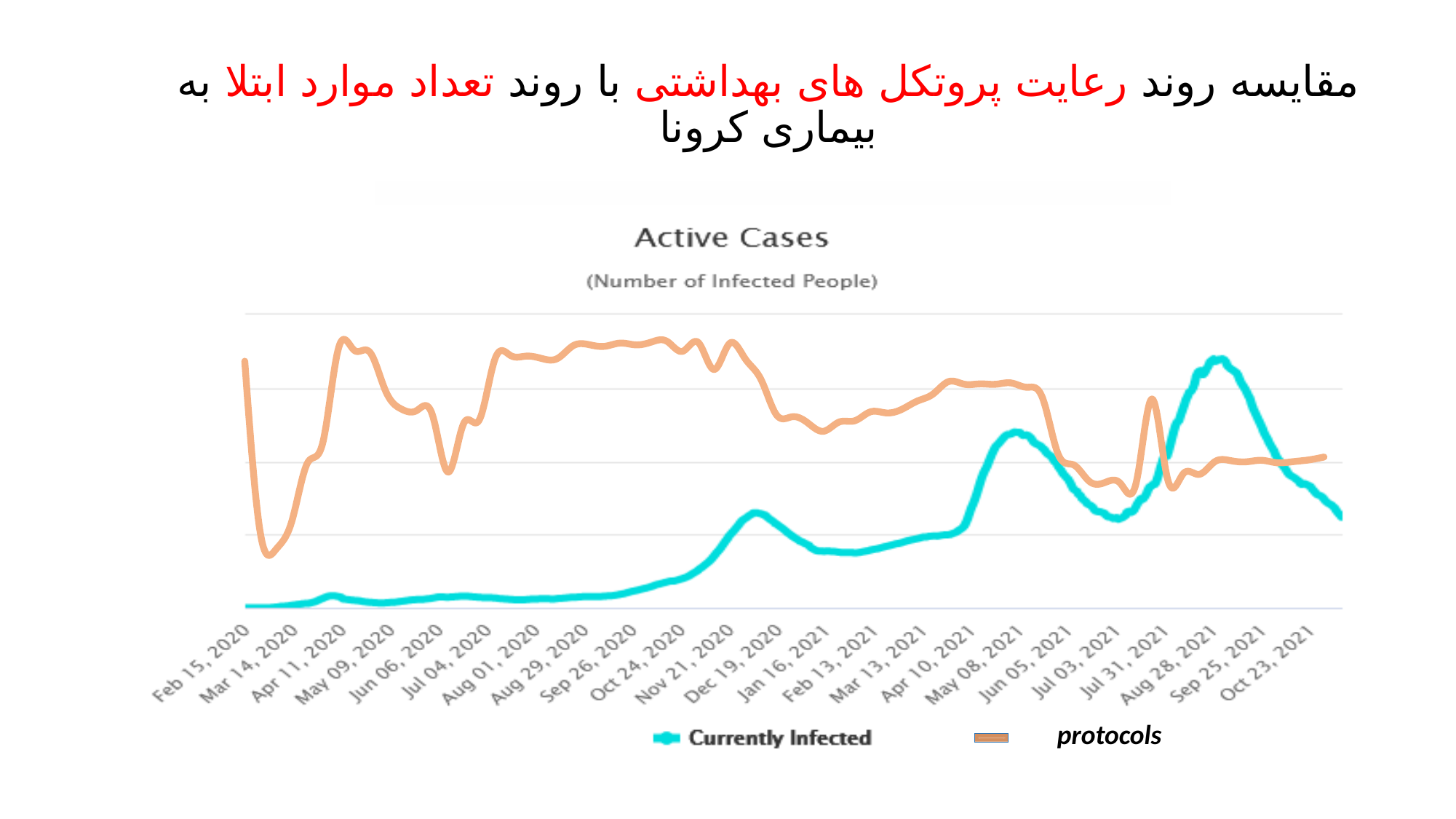
At Feb 15, 2020, which series is higher: Currently Infected or protocols? protocols How many series does the chart legend list? 2 What is the first date label on the x axis? Feb 15, 2020 How many date labels are shown along the x axis? 23 Around Aug 28, 2021, which series is higher: Currently Infected or protocols? Currently Infected What are the two series named in the chart legend? Currently Infected and protocols Does the Currently Infected line rise or fall between Sep 25, 2021 and Oct 23, 2021? fall Does the Currently Infected line rise or fall between Apr 10, 2021 and May 08, 2021? rise What kind of chart is shown on the slide? line chart Near which x-axis date does the Currently Infected line reach its highest point? Aug 28, 2021 What is the title of the chart? Active Cases What is the last date label on the x axis? Oct 23, 2021